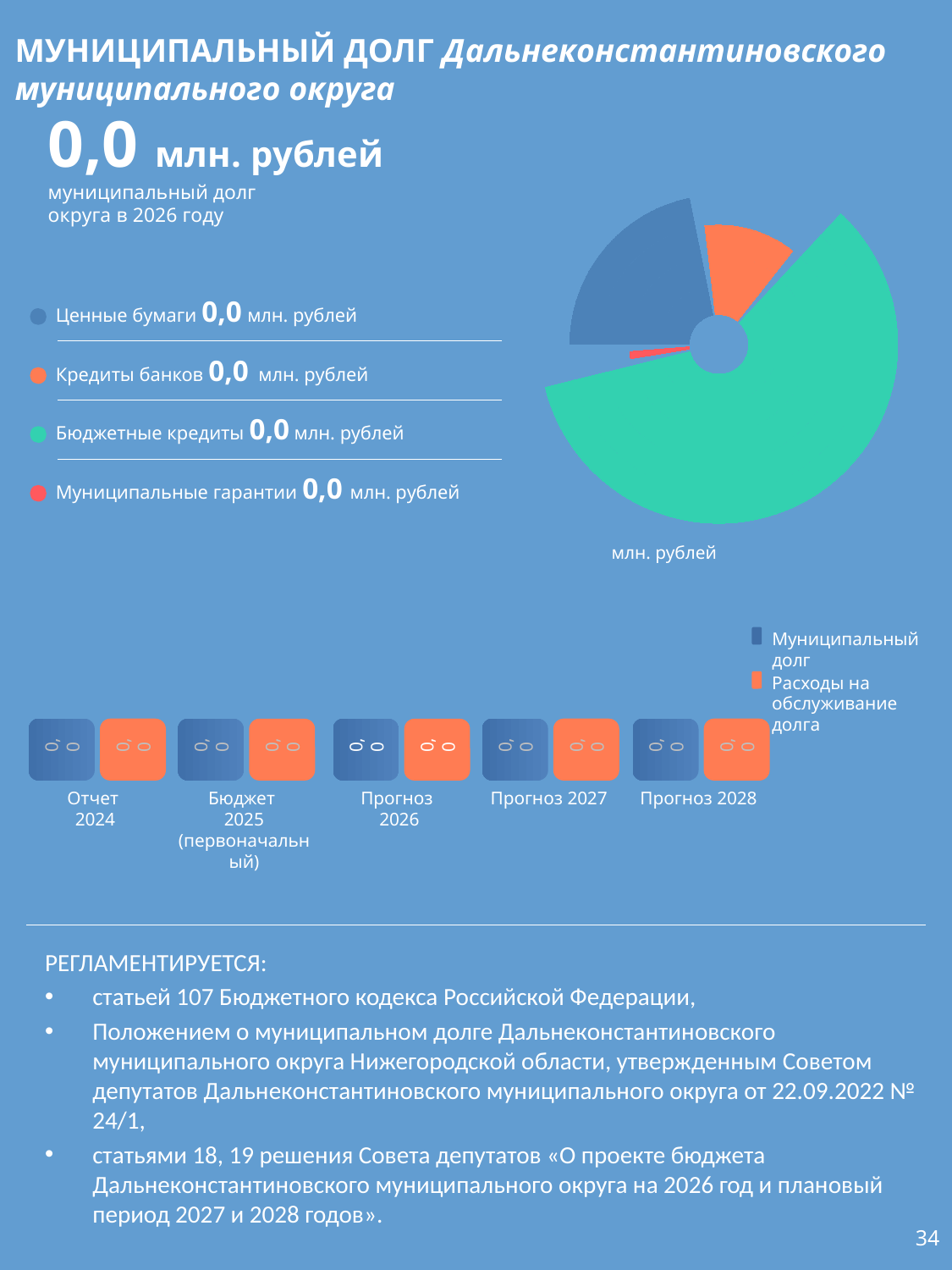
In the bar chart, which series is shown in orange? Расходы на обслуживание долга How many categories are shown along the x axis of the bar chart? 5 In the pie chart legend, what is the value for Ценные бумаги? 0,0 млн. рублей What kind of chart is shown in the upper right of the slide? doughnut chart What kind of chart is shown in the middle of the slide with the categories Отчет 2024 through Прогноз 2028? bar chart How many series does the legend of the bar chart list? 2 In the pie chart legend, what is the value for Бюджетные кредиты? 0,0 млн. рублей In the pie chart legend, what is the value for Муниципальные гарантии? 0,0 млн. рублей How many categories are listed in the legend of the pie chart? 4 In the pie chart legend, what is the value for Кредиты банков? 0,0 млн. рублей In the bar chart, which series is shown in dark blue? Муниципальный долг What is the municipal debt of the district in 2026 according to the headline figure on the slide? 0,0 млн. рублей